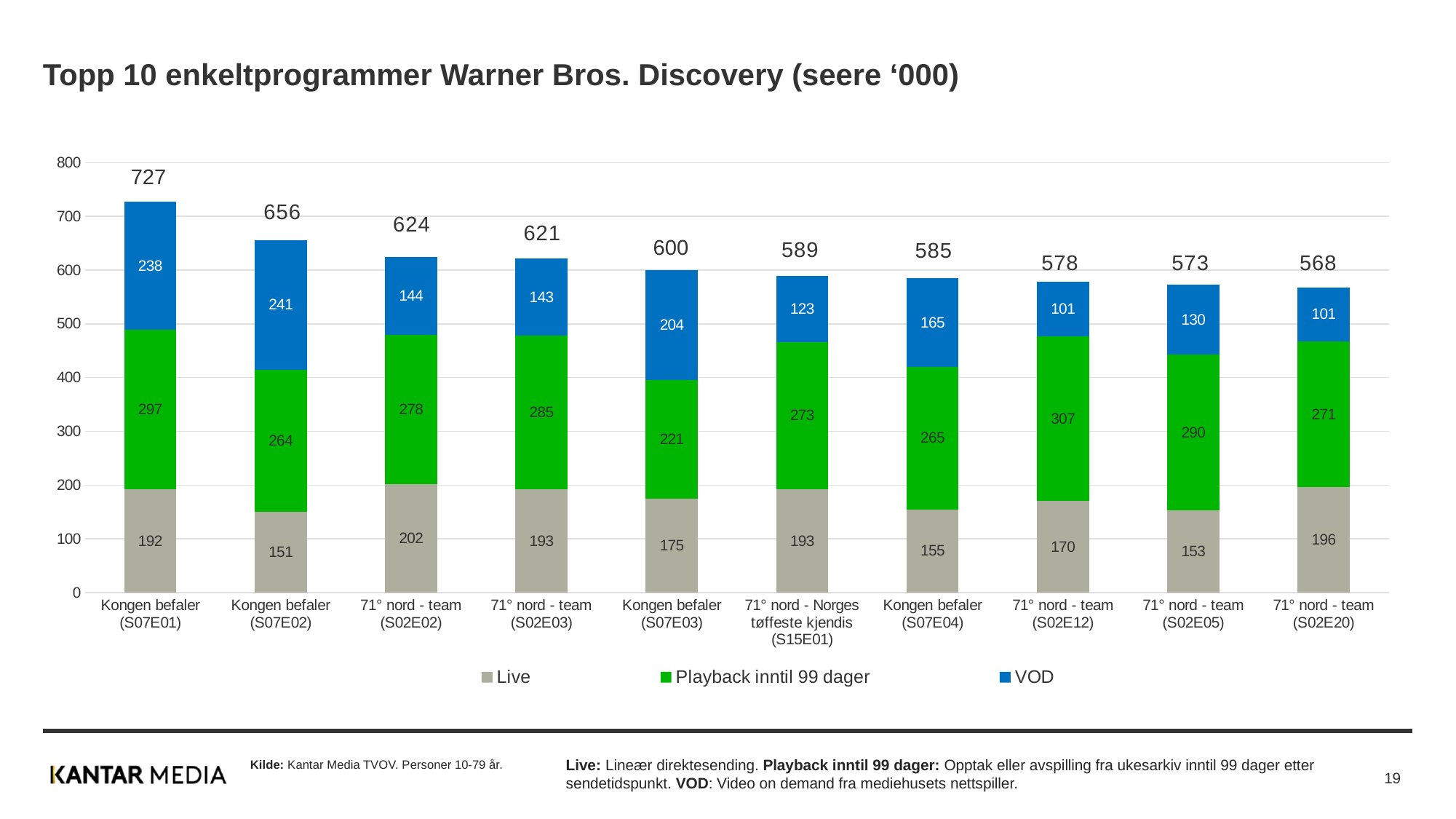
What is the Live value for Kongen befaler (S07E01)? 192 How many programs are shown on the chart? 10 Which is larger, the VOD value for Kongen befaler (S07E04) or the VOD value for 71° nord - team (S02E05)? Kongen befaler (S07E04) Do the totals rise or fall from left to right along the x axis? Fall What is the total for the 71° nord - Norges tøffeste kjendis (S15E01) bar? 589 How many series does the legend list? 3 Which program has the lowest total? 71° nord - team (S02E20) What is the VOD value for Kongen befaler (S07E03)? 204 Which program has the highest total? Kongen befaler (S07E01) What is the Playback inntil 99 dager value for 71° nord - team (S02E12)? 307 What is the difference between the totals of Kongen befaler (S07E01) and Kongen befaler (S07E02)? 71 What kind of chart is this? Stacked bar chart